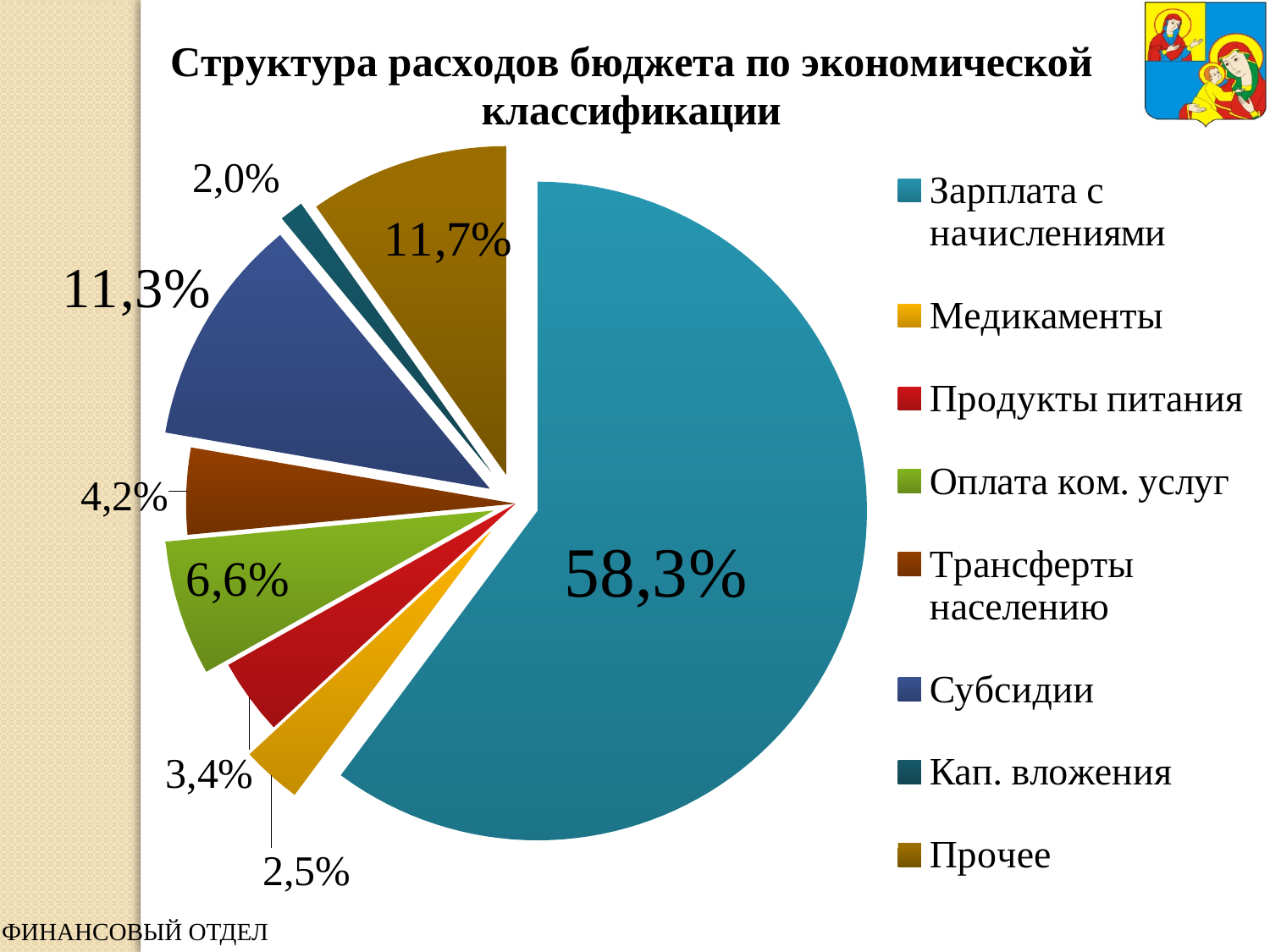
What is the value shown for "Кап. вложения"? 2,0% Which is larger, the share for "Продукты питания" or the share for "Медикаменты"? Продукты питания What is the value shown for "Оплата ком. услуг"? 6,6% What is the value shown for "Прочее"? 11,7% What is the title of the chart? Структура расходов бюджета по экономической классификации What kind of chart is shown on the slide? pie chart Which category has the largest share of the pie? Зарплата с начислениями Which category has the smallest share of the pie? Кап. вложения What is the difference between the shares for "Прочее" and "Субсидии"? 0,4% What is the value shown for "Субсидии"? 11,3% How many categories does the legend of the pie chart list? 8 What share of the pie does "Зарплата с начислениями" have? 58,3%